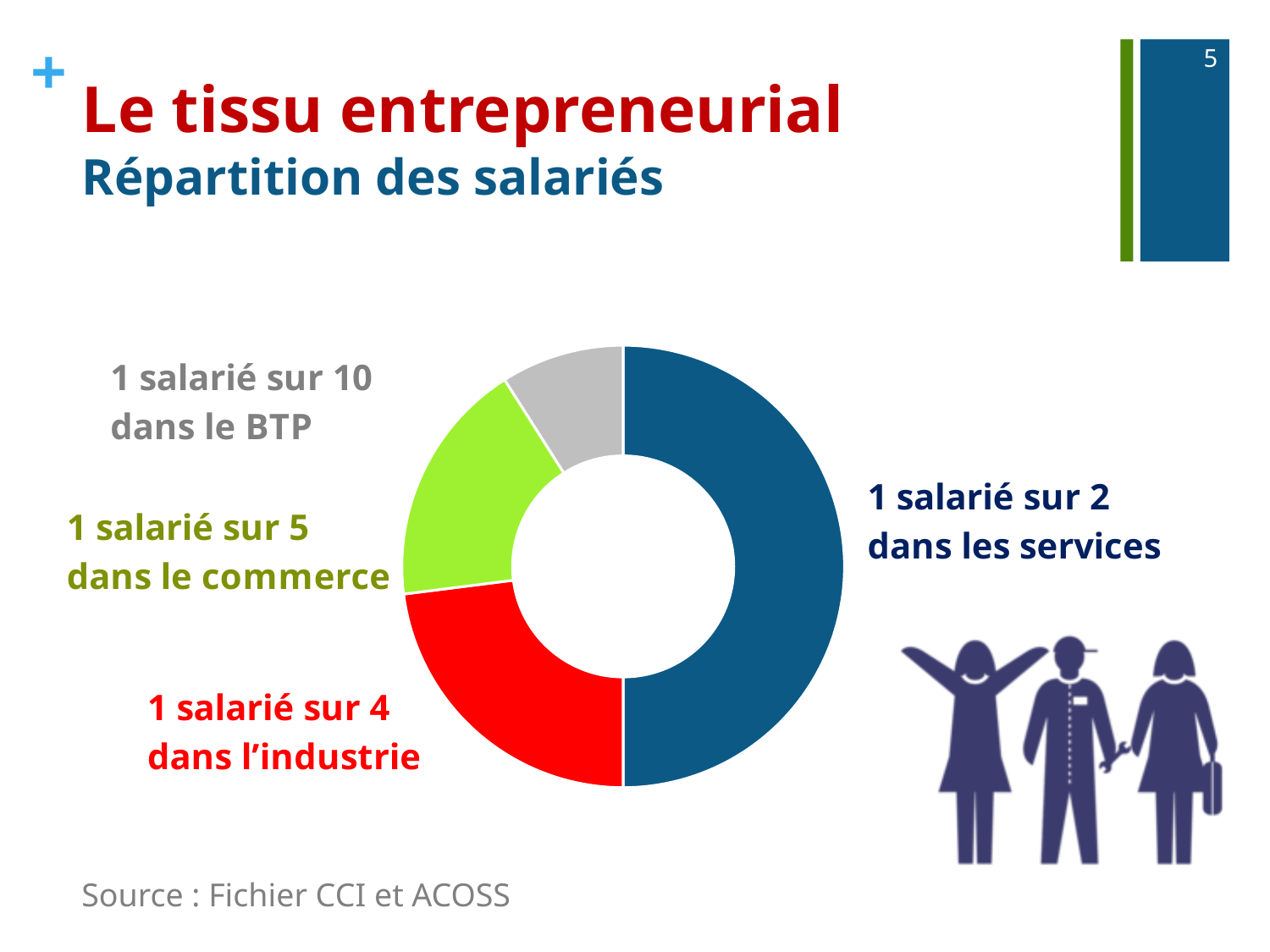
According to the chart, what proportion of employees work in industry (industrie)? 1 salarié sur 4 What is the subtitle of the chart on the slide? Répartition des salariés According to the chart, what proportion of employees work in services? 1 salarié sur 2 According to the chart, what proportion of employees work in commerce? 1 salarié sur 5 Which sector has a larger share of employees, commerce or BTP? Commerce Which sector accounts for the largest share of employees in the chart? Services Which sector has a larger share of employees, industrie or commerce? Industrie According to the chart, what proportion of employees work in the BTP (construction) sector? 1 salarié sur 10 Which sector accounts for the smallest share of employees in the chart? BTP What kind of chart is shown on the slide? Donut (pie) chart What colour is the segment representing services in the donut chart? Blue How many sectors (segments) does the donut chart show? 4